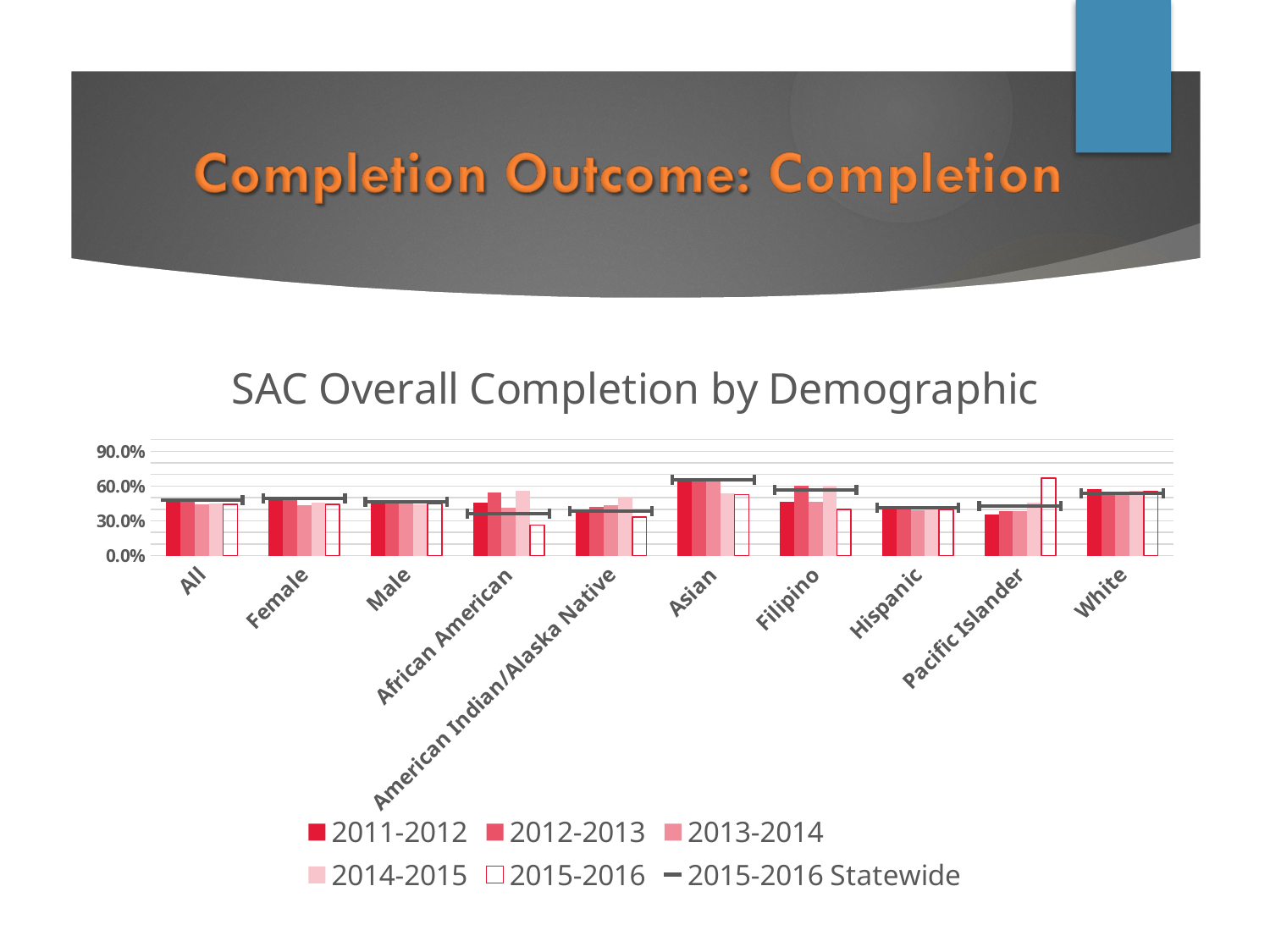
Is the 2011-2012 value for Male greater or less than 60%? less Which demographic has the highest 2011-2012 value? Asian What type of chart is shown on the slide? Bar chart How many demographic categories are shown on the x axis? 10 Do the Pacific Islander values rise or fall from 2011-2012 to 2015-2016? rise Which demographic has the lowest 2015-2016 value? African American What is the title of the chart? SAC Overall Completion by Demographic How many series does the legend list? 6 Which is larger, the 2011-2012 value for Asian or the 2011-2012 value for Hispanic? Asian Is the 2015-2016 value for Pacific Islander greater or less than 60%? greater Is the 2015-2016 value for African American greater or less than 30%? less